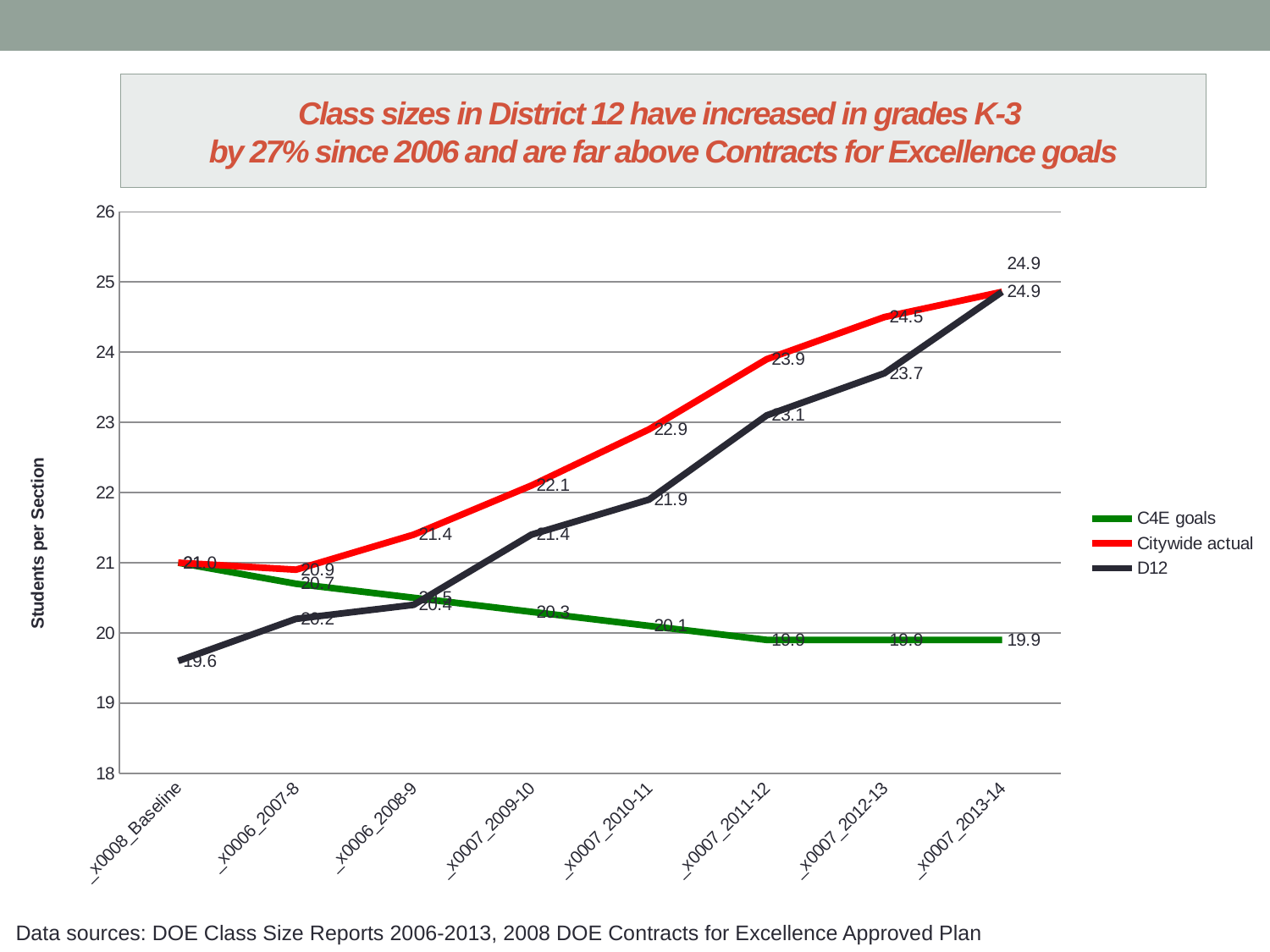
What is the D12 value for 2012-13? 23.7 What is the label of the y axis? Students per Section What is the Citywide actual value for 2011-12? 23.9 How many series does the legend list? 3 Which is larger in 2012-13, the Citywide actual value or the D12 value? Citywide actual What is the D12 value for 2013-14? 24.9 What is the D12 value at the Baseline point? 19.6 How many points are plotted along the x axis for each series? 8 What is the difference between the D12 value for 2013-14 and the D12 value at the Baseline? 5.3 Does the D12 line rise or fall from the Baseline to 2013-14? Rise What is the C4E goals value for 2013-14? 19.9 What type of chart is shown on the slide? Line chart